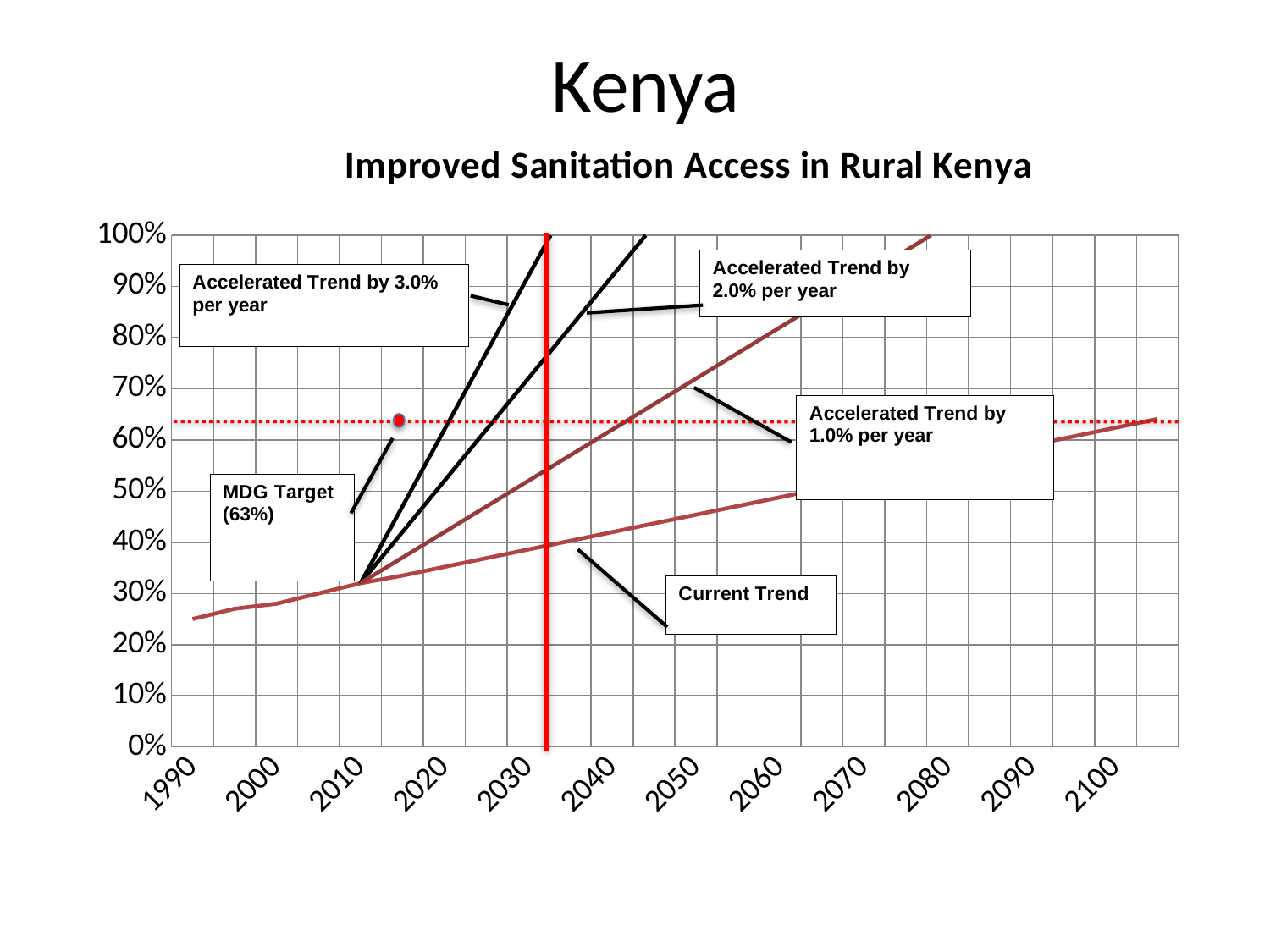
Does the Current Trend line rise or fall from 1990 to 2100? Rise What is the title of the chart? Improved Sanitation Access in Rural Kenya What value is given for the MDG Target on the chart? 63% Which trend line is lowest in 2050? Current Trend Which trend line reaches 100% earliest? Accelerated Trend by 3.0% per year In 2030, which is higher: the Accelerated Trend by 3.0% per year or the Accelerated Trend by 1.0% per year? Accelerated Trend by 3.0% per year How many trend lines are labelled on the chart? 4 Is the Current Trend value in 2035 greater or less than 50%? less What kind of chart is shown on the slide? Line chart Is the Accelerated Trend by 1.0% per year value in 2050 greater or less than 60%? greater How many year labels are shown on the x axis? 12 Is the Current Trend value in 1990 greater or less than 30%? less